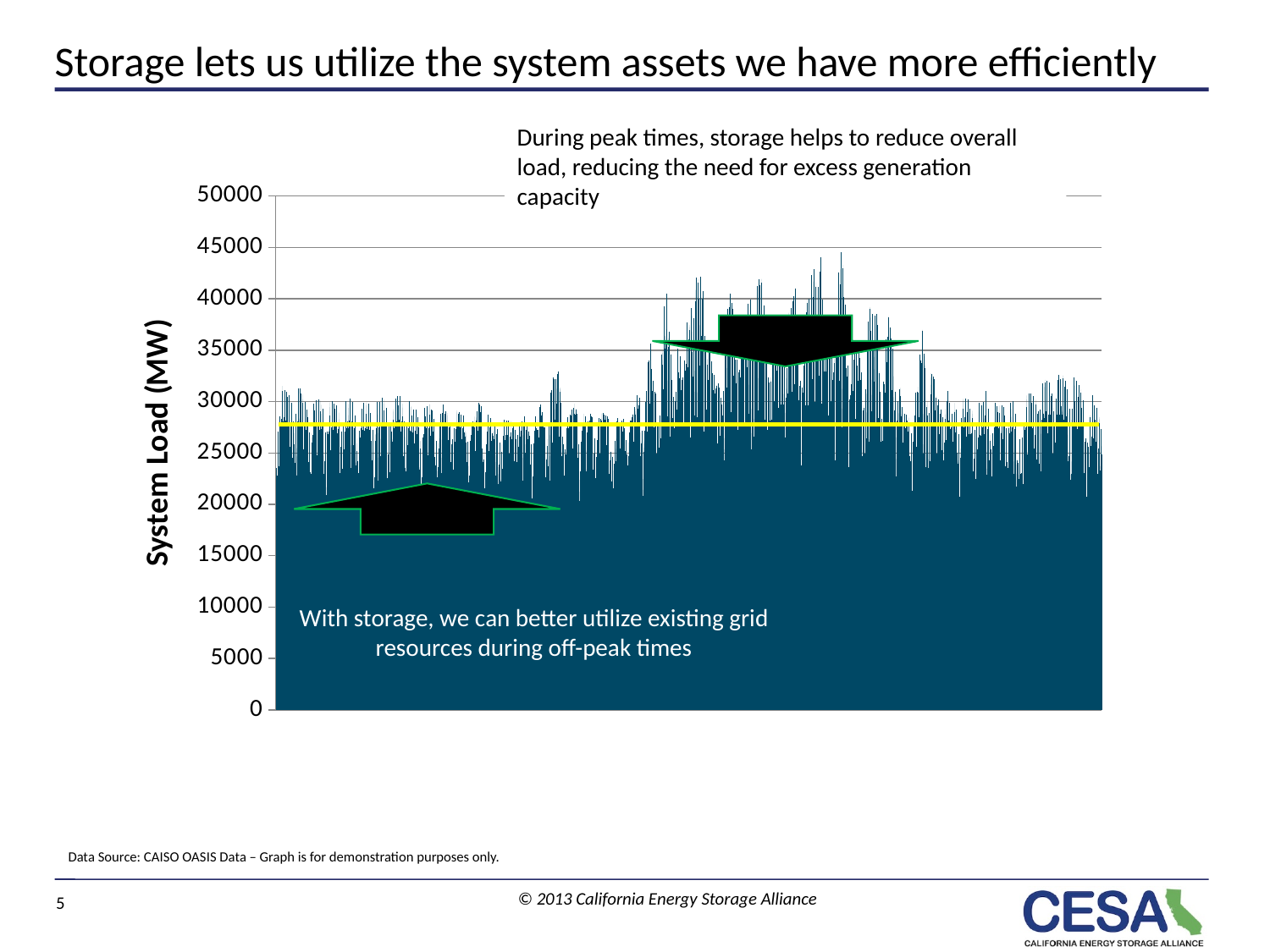
Does the yellow horizontal line on the chart sit above or below the 25000 gridline? above What kind of chart is shown on the slide? area chart Do the system load values rise or fall from the middle of the chart toward its right-hand end? fall Does the yellow horizontal line on the chart sit above or below the 30000 gridline? below Is the highest system load value plotted on the chart greater or less than 40000? greater What is the highest tick value shown on the vertical axis? 50000 What is the label of the vertical axis of the chart? System Load (MW) Are the system load values in the middle portion of the chart higher or lower than those at the left-hand start of the chart? higher